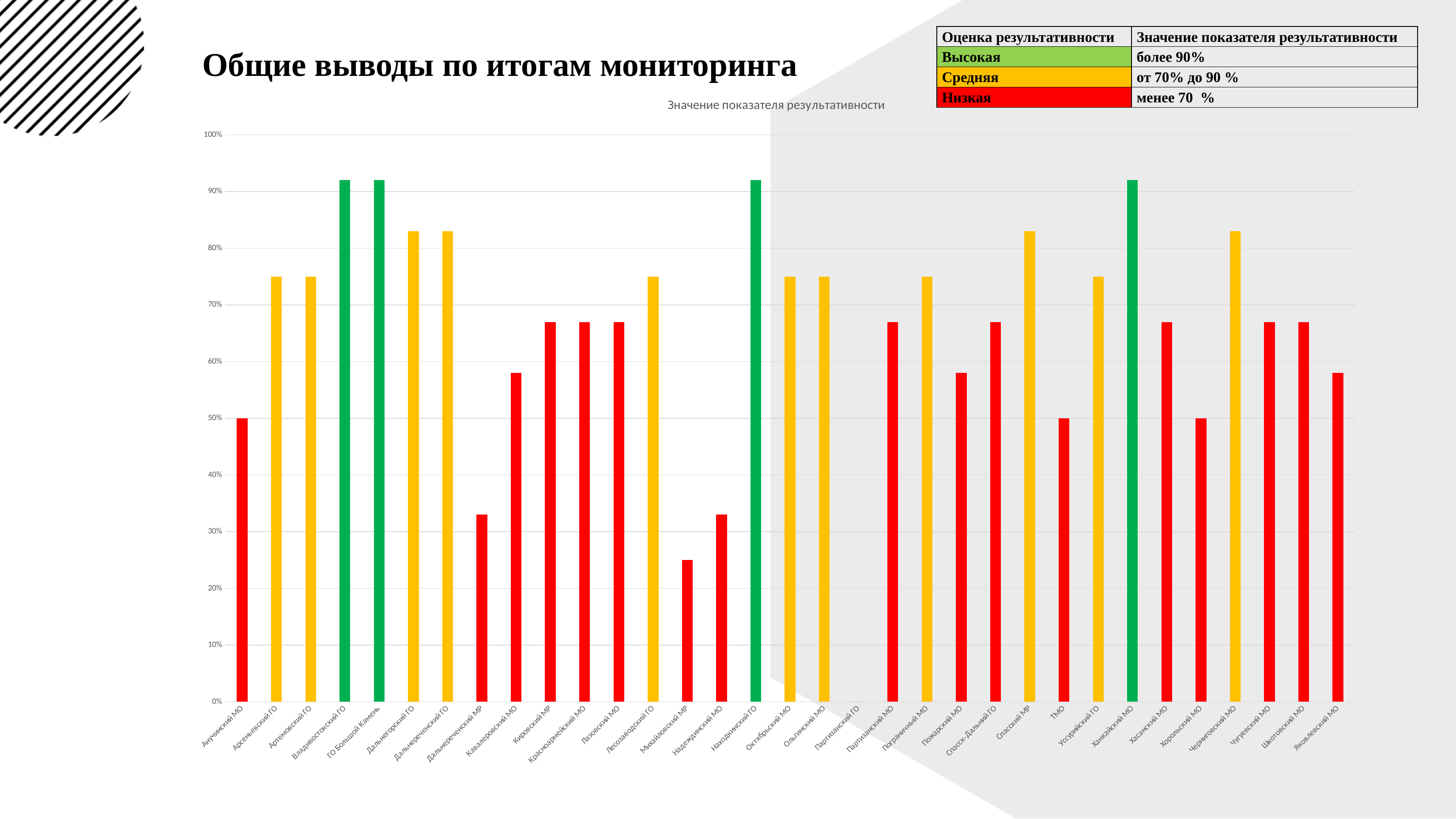
Is the value for Кавалеровский МО greater or less than 60%? less What is the title of the chart? Значение показателя результативности Is the value for Дальнегорский ГО greater or less than 80%? greater Is the value for Михайловский МР greater or less than 30%? less What kind of chart is shown on the slide? bar chart What is the value for ТМО? 50% How many green bars are there in the chart? 4 Which is larger, the value for Спасский МР or the value for Пожарский МО? Спасский МР What is the value for Хорольский МО? 50% Which is larger, the value for Арсеньевский ГО or the value for Анучинский МО? Арсеньевский ГО What is the value for Анучинский МО? 50%